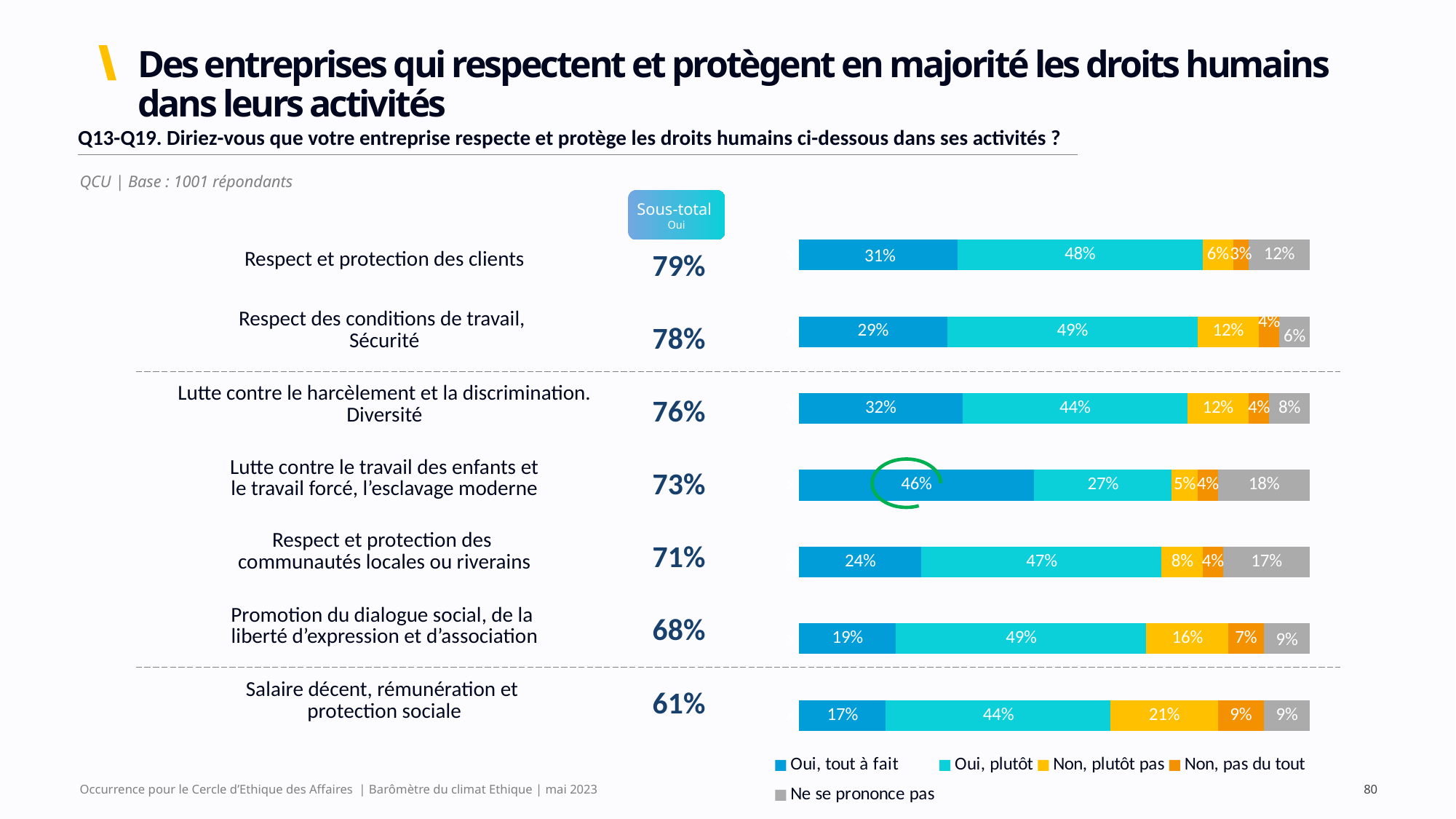
What type of chart is shown on the slide? Stacked bar chart What is the 'Non, plutôt pas' value for 'Salaire décent, rémunération et protection sociale'? 21% What is the 'Ne se prononce pas' value for 'Respect et protection des communautés locales ou riverains'? 17% How many series does the legend list? 5 How many categories (human rights items) are plotted in the chart? 7 What is the difference between the 'Oui, plutôt' values for 'Respect des conditions de travail, Sécurité' and 'Lutte contre le travail des enfants et le travail forcé, l'esclavage moderne'? 22 percentage points Which category has the lowest 'Sous-total Oui' value? Salaire décent, rémunération et protection sociale What is the 'Oui, tout à fait' value for 'Lutte contre le travail des enfants et le travail forcé, l'esclavage moderne'? 46% What is the combined 'Oui, tout à fait' and 'Oui, plutôt' total for 'Respect et protection des clients'? 79% Which category has the highest 'Oui, tout à fait' value? Lutte contre le travail des enfants et le travail forcé, l'esclavage moderne Which is larger: the 'Non, pas du tout' value for 'Promotion du dialogue social, de la liberté d'expression et d'association' or for 'Respect et protection des clients'? Promotion du dialogue social, de la liberté d'expression et d'association Which colour represents 'Ne se prononce pas' in the chart? Grey